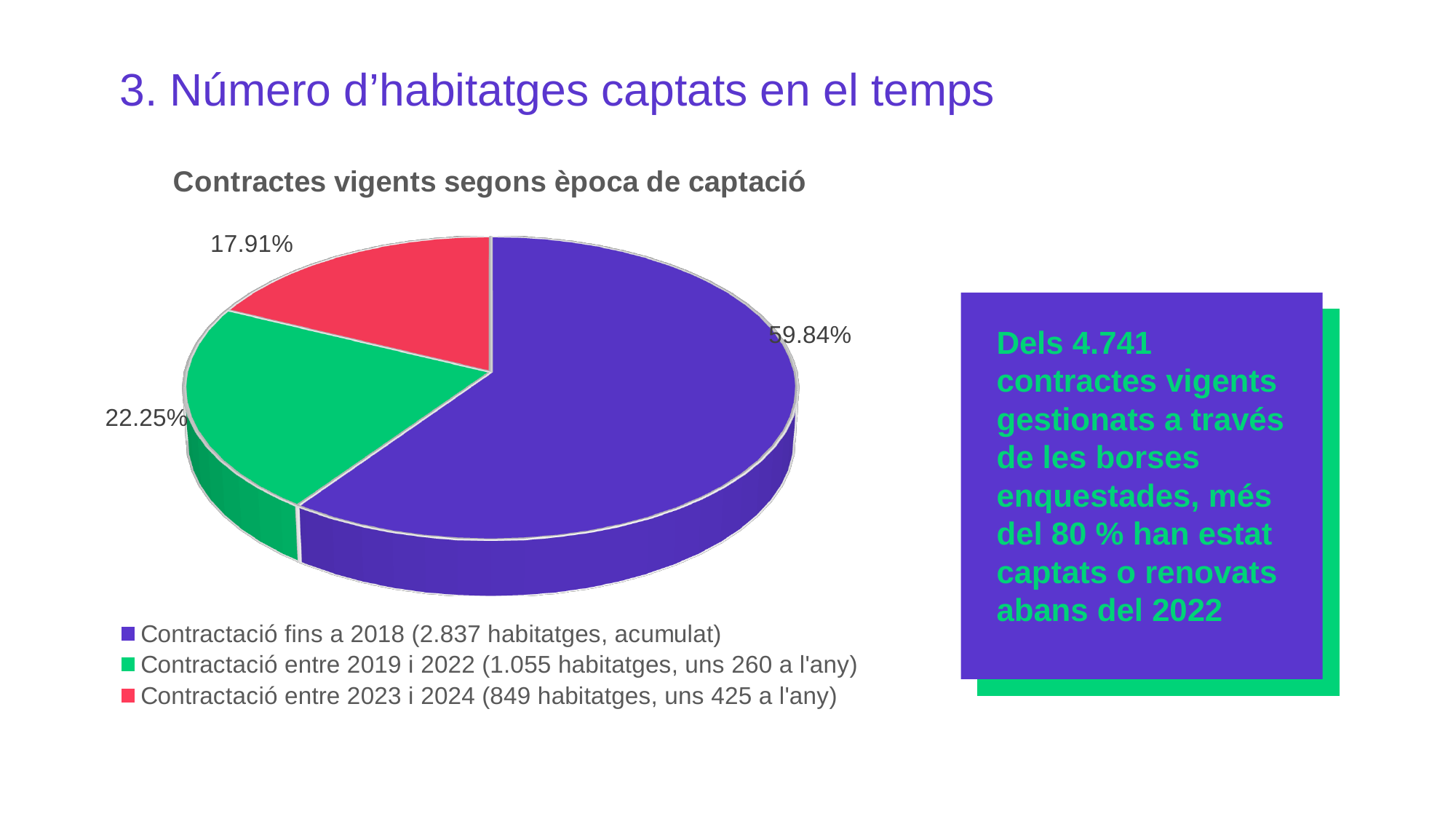
What is the title of the chart? Contractes vigents segons època de captació According to the legend, how many habitatges correspond to 'Contractació entre 2019 i 2022'? 1.055 Which category has the largest slice of the pie? Contractació fins a 2018 Which category has the smallest slice of the pie? Contractació entre 2023 i 2024 Which slice is larger: 'Contractació entre 2019 i 2022' or 'Contractació entre 2023 i 2024'? Contractació entre 2019 i 2022 What is the difference in percentage points between the 'Contractació fins a 2018' slice and the 'Contractació entre 2019 i 2022' slice? 37.59 What colour is the slice for 'Contractació entre 2023 i 2024'? Red What percentage share does the slice for 'Contractació entre 2023 i 2024' have? 17.91% What percentage share does the slice for 'Contractació fins a 2018' have? 59.84% What percentage share does the slice for 'Contractació entre 2019 i 2022' have? 22.25% How many slices does the pie chart have? 3 What type of chart is shown on the slide? Pie chart